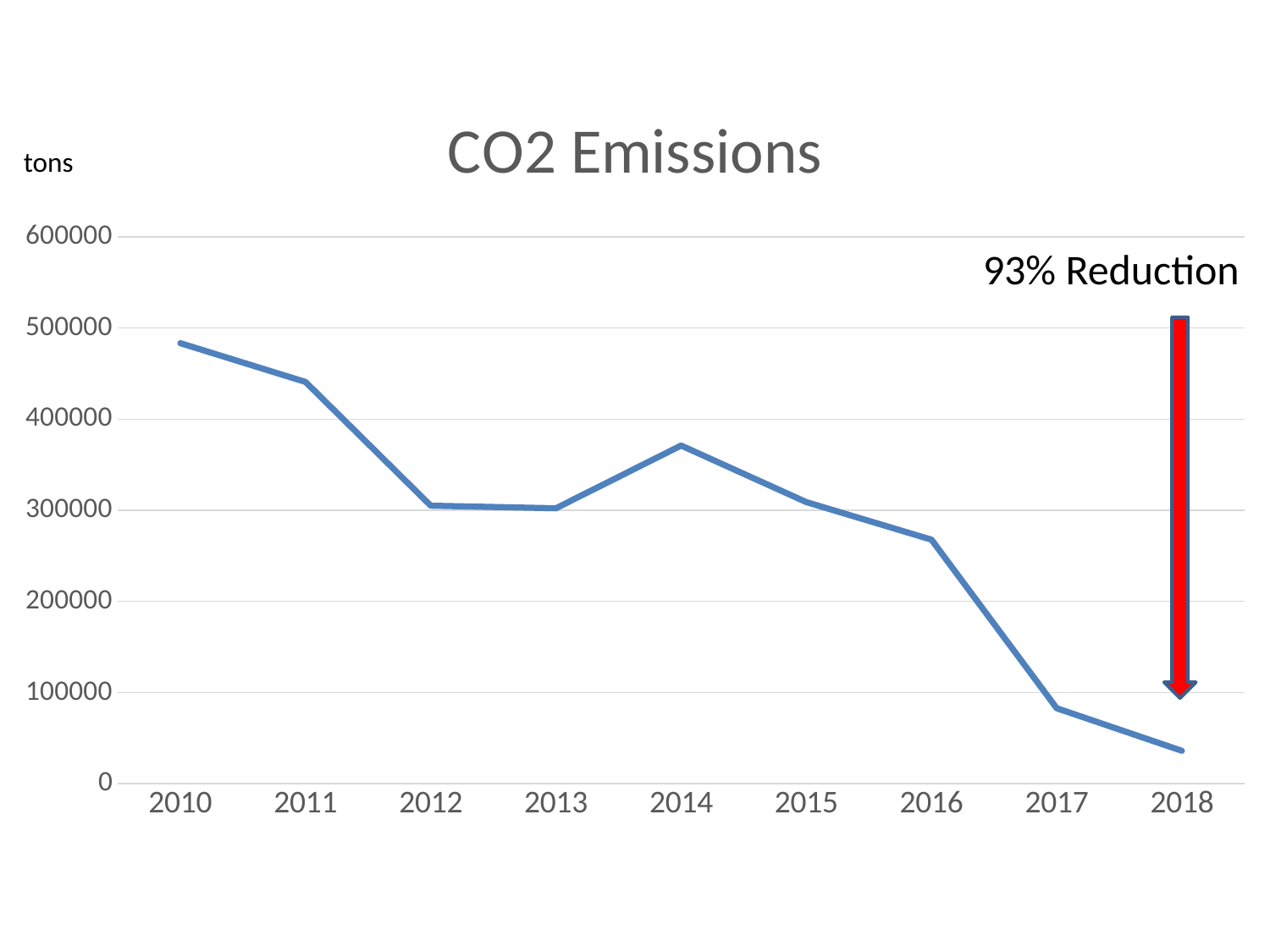
How many years are plotted on the x axis of the chart? 9 Which year has the lowest CO2 emissions? 2018 Is the value for 2017 greater or less than 100000? less What unit is shown for the vertical axis of the chart? tons Overall, do CO2 emissions rise or fall from 2010 to 2018? fall What type of chart is shown on the slide? line chart Which year has higher CO2 emissions, 2014 or 2015? 2014 Is the value for 2010 greater or less than 400000? greater Is the value for 2016 greater or less than 300000? less Which year has the highest CO2 emissions? 2010 What is the title of the chart? CO2 Emissions